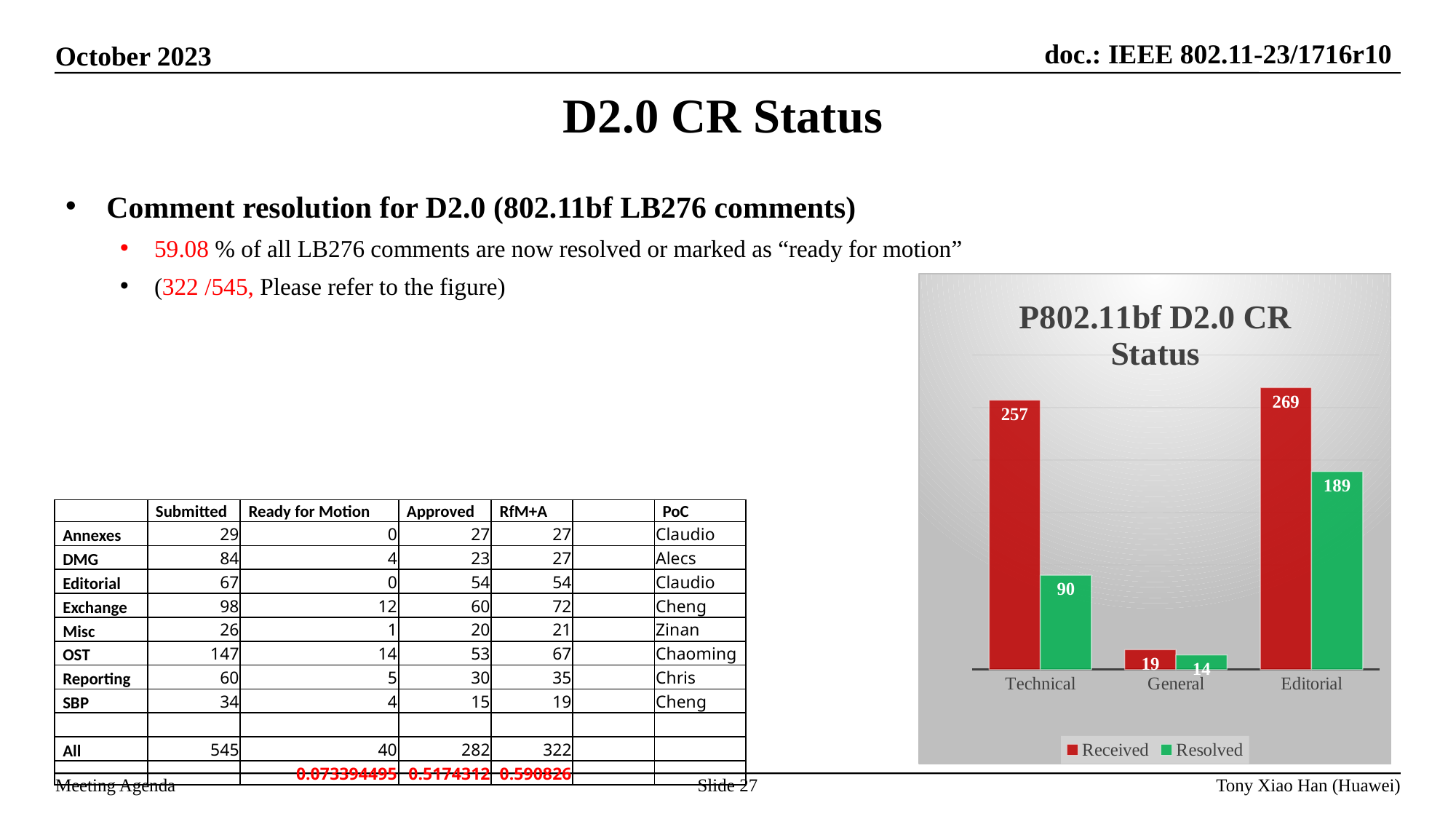
Is the Resolved value for Technical larger or smaller than the Resolved value for Editorial? smaller Which category has the lowest Resolved value? General What is the difference between Received and Resolved for Editorial? 80 What is the difference between Received and Resolved for Technical? 167 What is the title of the chart? P802.11bf D2.0 CR Status How many categories are shown on the x axis? 3 How many series does the legend list? 2 What is the Resolved value for Editorial? 189 What kind of chart is shown? bar chart Which category has the highest Received value? Editorial What is the Received value for Technical? 257 What is the Resolved value for General? 14